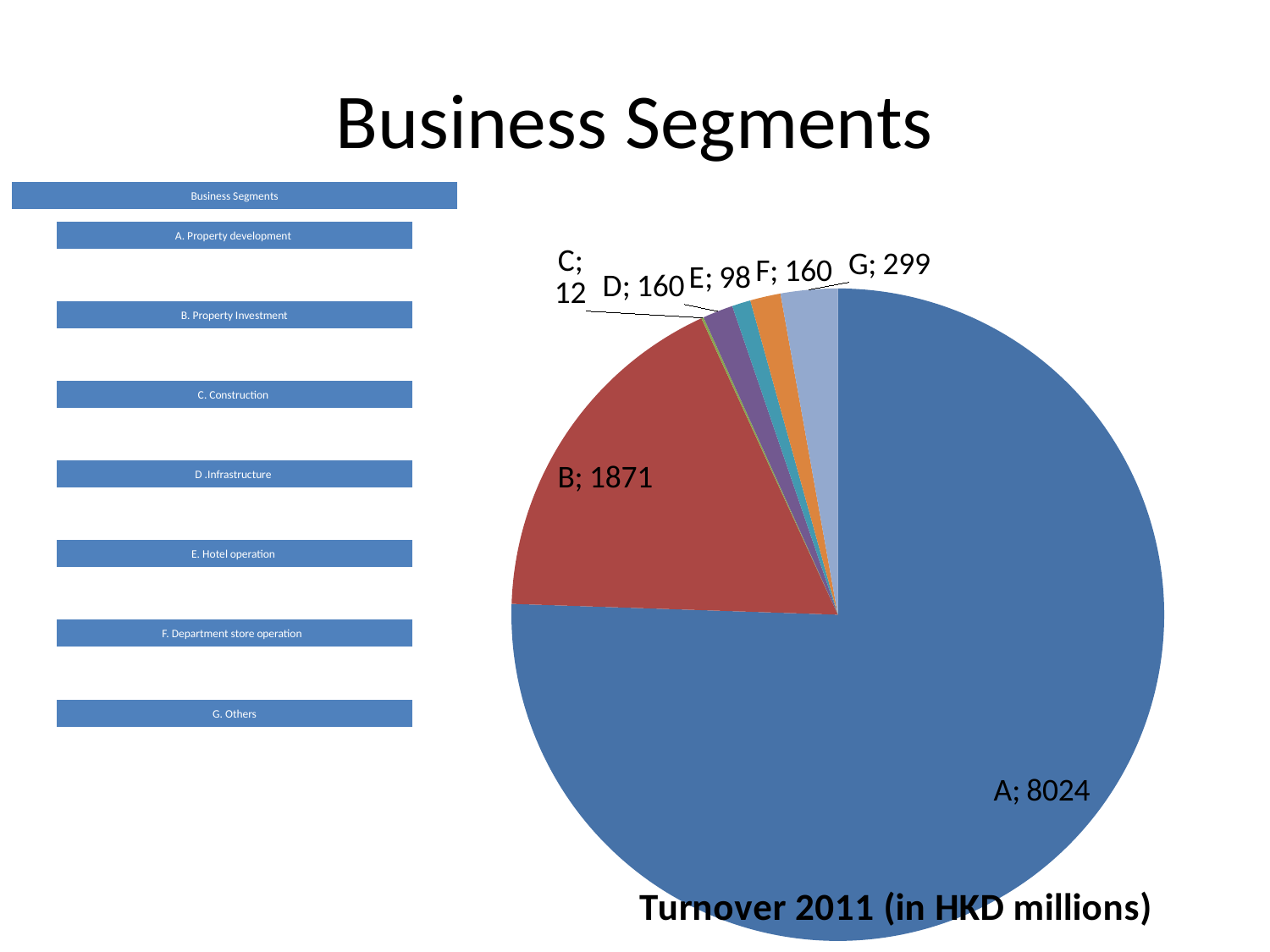
What share of the total turnover does segment A represent? 75.5% How many slices does the pie chart have? 7 Which segment has the smallest value in the pie chart? C What is the value for segment A in the pie chart? 8024 What is the title of the pie chart? Turnover 2011 (in HKD millions) What type of chart is shown on the slide? Pie chart What is the value for segment G in the pie chart? 299 Which is larger, the value for segment D or segment E? D What is the difference between the values for segments A and B? 6153 Which segment has the largest slice in the pie chart? A What is the value for segment B in the pie chart? 1871 What is the value for segment E in the pie chart? 98